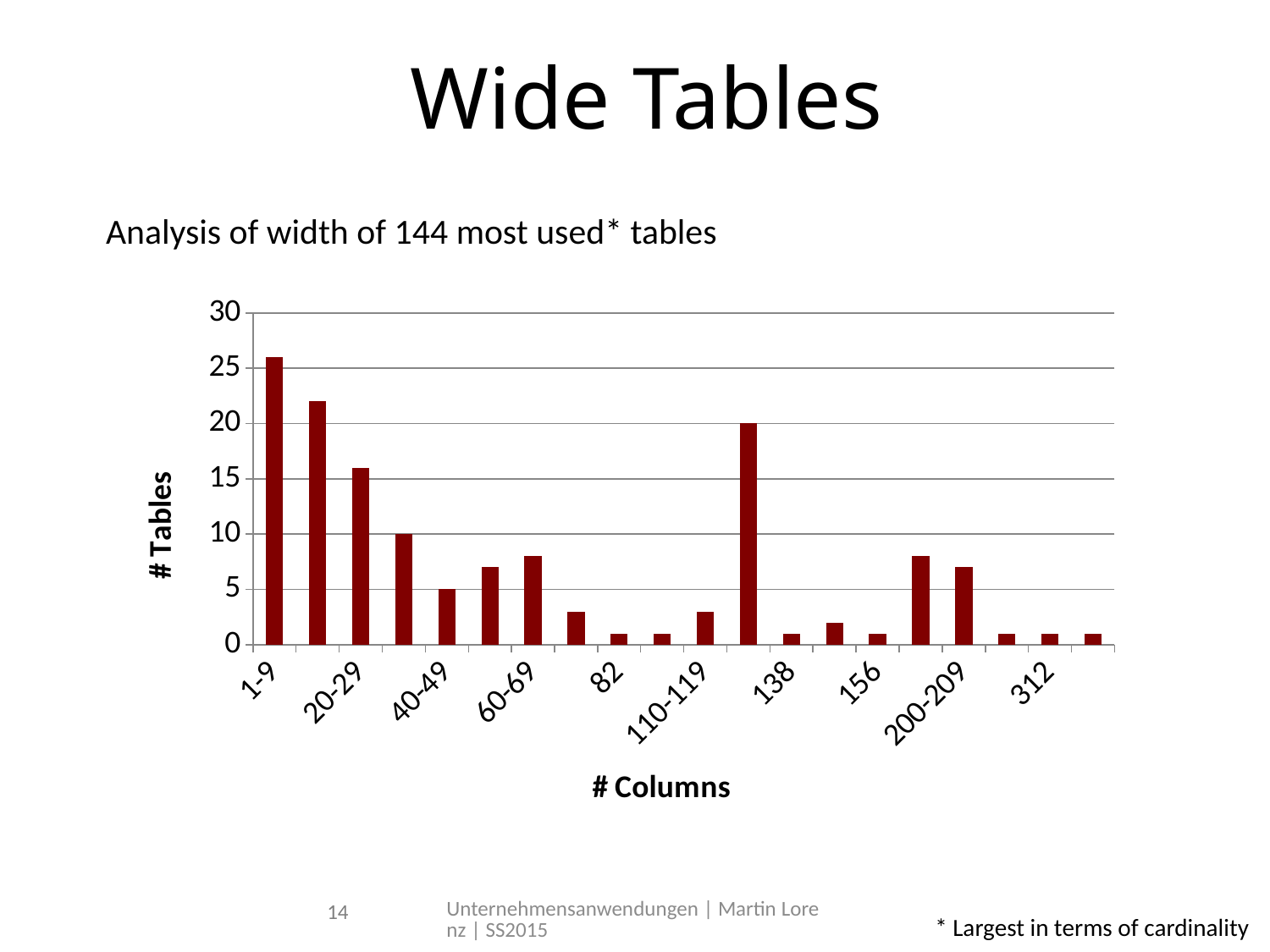
Which has more tables, 1-9 or 20-29? 1-9 Is the value for 1-9 greater or less than 25? greater Is the value for 60-69 greater or less than 10? less Is the value for 110-119 greater or less than 5? less Which column-count category has the highest number of tables? 1-9 Do the values rise or fall from 1-9 to 40-49? fall Which has more tables, 60-69 or 40-49? 60-69 What kind of chart is shown on the slide? bar chart What is the title of the vertical axis? # Tables How many bars are plotted in the chart? 20